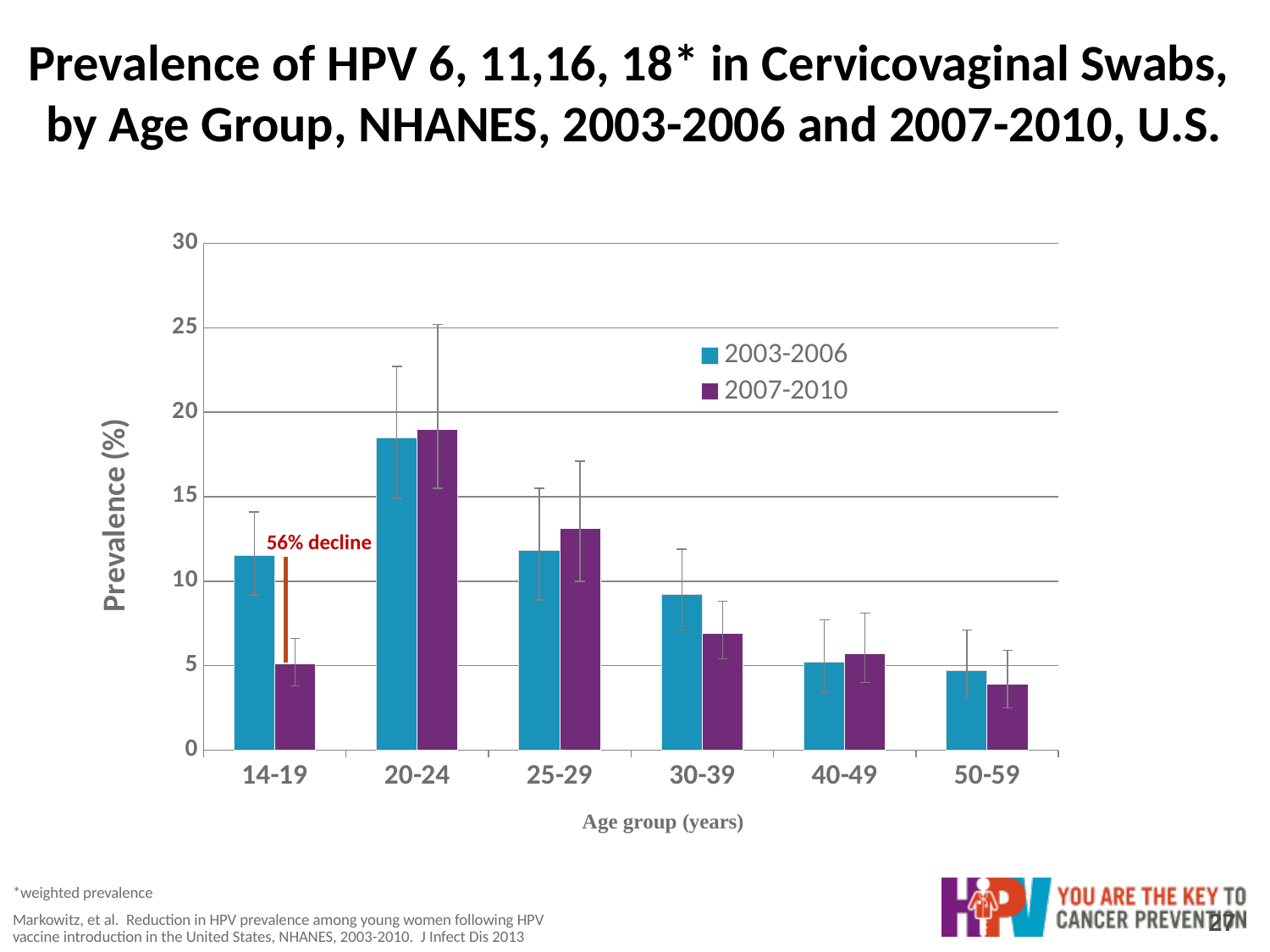
Is the 2003-2006 prevalence for the 20-24 age group greater or less than 20? less For the 14-19 age group, which series has the larger prevalence, 2003-2006 or 2007-2010? 2003-2006 What percentage decline is annotated on the chart for the 14-19 age group? 56% decline For the 25-29 age group, which series has the larger prevalence, 2003-2006 or 2007-2010? 2007-2010 From the 20-24 age group to the 50-59 age group, does the 2003-2006 prevalence rise or fall? fall How many age groups are shown on the x axis? 6 What kind of chart is shown on the slide? bar chart Which age group has the highest prevalence for the 2003-2006 series? 20-24 How many series does the legend list? 2 Which age group has the highest prevalence for the 2007-2010 series? 20-24 Is the 2003-2006 prevalence for the 14-19 age group greater or less than 10? greater Which age group has the lowest prevalence for the 2007-2010 series? 50-59